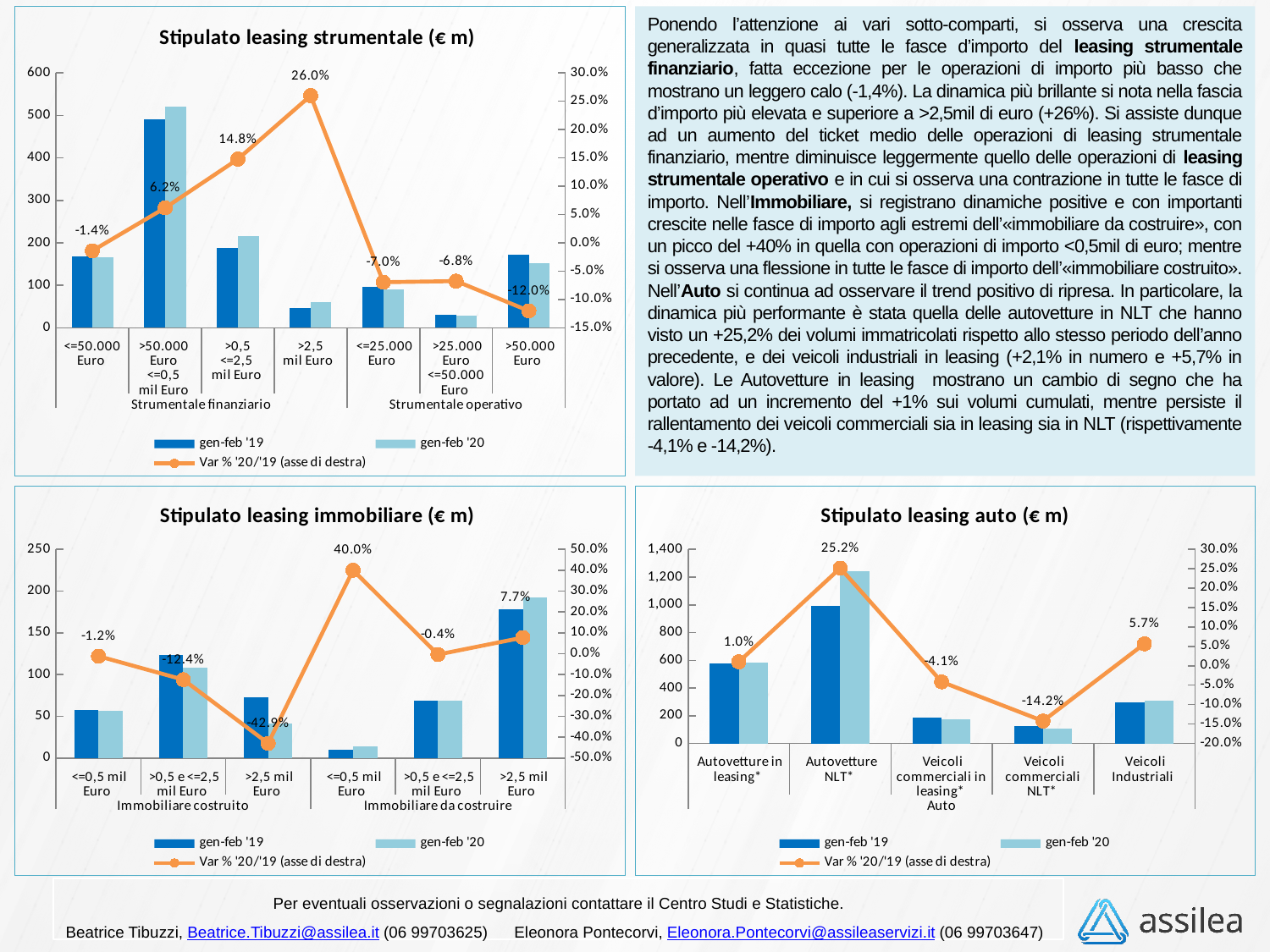
In the 'Stipulato leasing immobiliare (€ m)' chart, which category has the lowest Var % '20/'19 value? >2,5 mil Euro (Immobiliare costruito) In the 'Stipulato leasing auto (€ m)' chart, is the gen-feb '19 bar for 'Autovetture NLT*' greater or less than 800? greater How many series does the legend of the 'Stipulato leasing immobiliare (€ m)' chart list? 3 In the 'Stipulato leasing strumentale (€ m)' chart, which category has the lowest Var % '20/'19 value? >50.000 Euro (Strumentale operativo) In the 'Stipulato leasing auto (€ m)' chart, what is the Var % '20/'19 value for 'Veicoli commerciali NLT*'? -14.2% In the 'Stipulato leasing strumentale (€ m)' chart, what is the difference between the Var % '20/'19 values for '>2,5 mil Euro' and '>0,5 <=2,5 mil Euro' in Strumentale finanziario? 11.2 percentage points In the 'Stipulato leasing auto (€ m)' chart, which category has the highest Var % '20/'19 value? Autovetture NLT* In the 'Stipulato leasing strumentale (€ m)' chart, what is the Var % '20/'19 value for the '>2,5 mil Euro' category of Strumentale finanziario? 26.0% In the 'Stipulato leasing immobiliare (€ m)' chart, is the Var % '20/'19 value for '>2,5 mil Euro' in Immobiliare da costruire larger or smaller than the value for '>0,5 e <=2,5 mil Euro' in Immobiliare da costruire? larger How many categories are shown on the x axis of the 'Stipulato leasing strumentale (€ m)' chart? 7 In the 'Stipulato leasing strumentale (€ m)' chart, is the gen-feb '20 bar for '>50.000 Euro <=0,5 mil Euro' greater or less than 400? greater In the 'Stipulato leasing immobiliare (€ m)' chart, what is the Var % '20/'19 value for '<=0,5 mil Euro' in Immobiliare da costruire? 40.0%